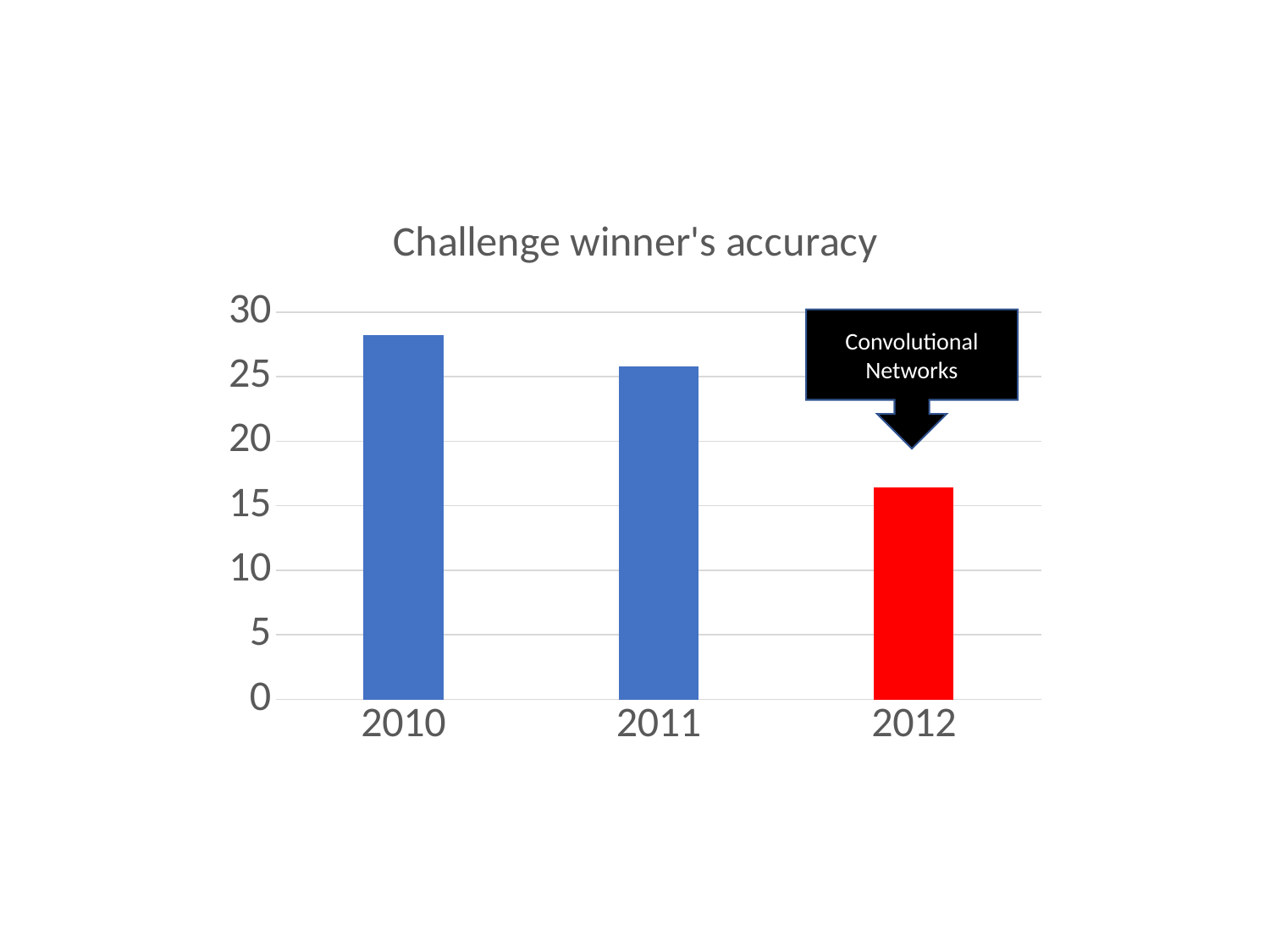
What kind of chart is shown on the slide? bar chart Which year has the lowest bar? 2012 What is the title of the chart? Challenge winner's accuracy How many bars are plotted in the chart? 3 Is the value for 2012 greater or less than 15? greater Is the value for 2011 greater or less than 25? greater Which is larger, the value for 2011 or the value for 2012? 2011 What label does the callout box above the 2012 bar show? Convolutional Networks Is the value for 2010 greater or less than 25? greater Do the values rise or fall from 2010 to 2012? fall Which year has the highest bar? 2010